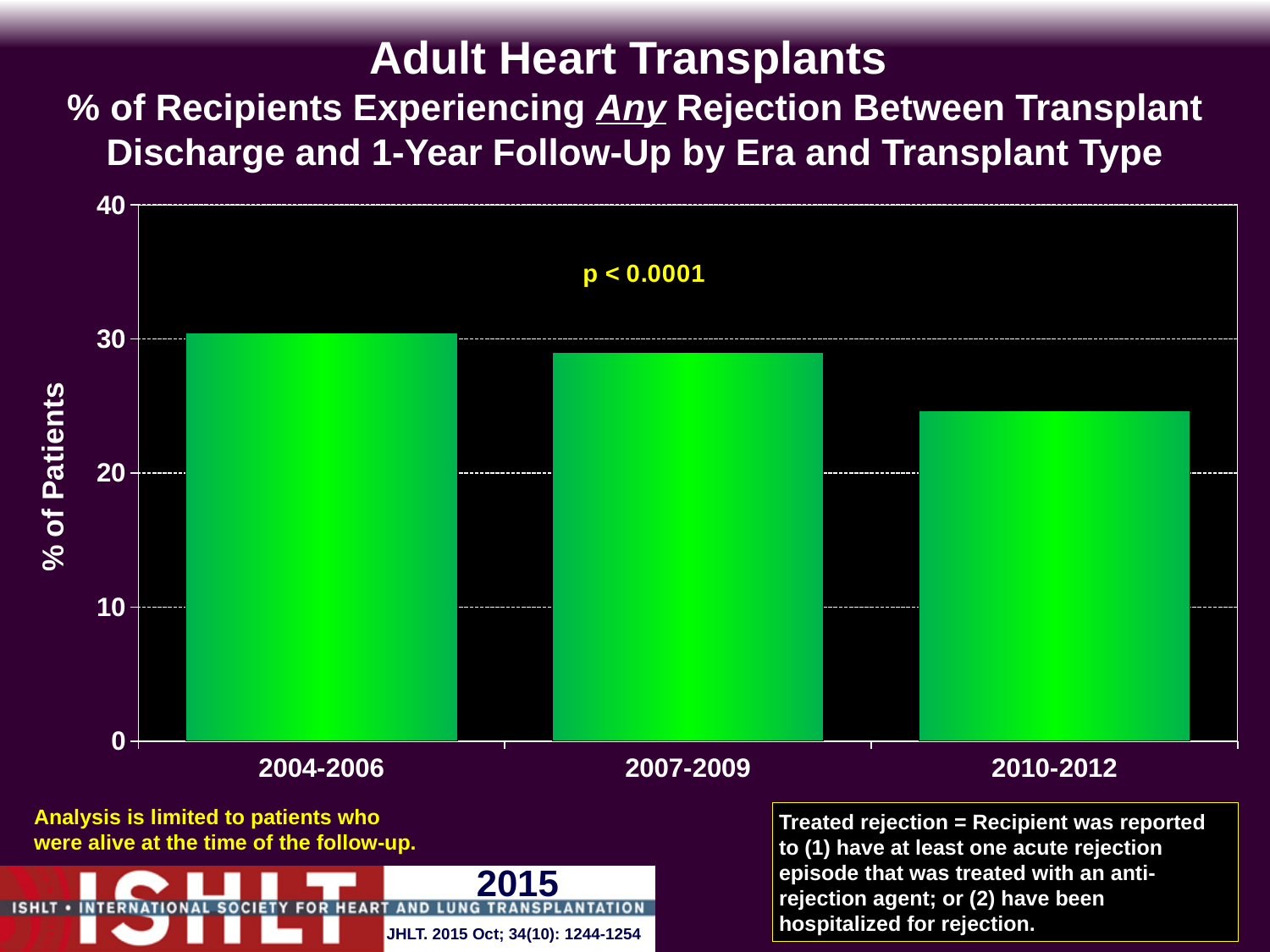
What p-value is printed on the chart? p < 0.0001 Is the value for 2010-2012 greater or less than 30? less What is the label on the y axis? % of Patients What kind of chart is shown on the slide? bar chart Is the value for 2007-2009 greater or less than 20? greater Which is larger, the value for 2007-2009 or the value for 2010-2012? 2007-2009 Do the values rise or fall across the eras from 2004-2006 to 2010-2012? fall Is the value for 2010-2012 greater or less than 20? greater How many era categories are shown on the x axis? 3 Which era has the lowest % of patients experiencing any rejection? 2010-2012 Which is larger, the value for 2004-2006 or the value for 2010-2012? 2004-2006 Which era has the highest % of patients experiencing any rejection? 2004-2006